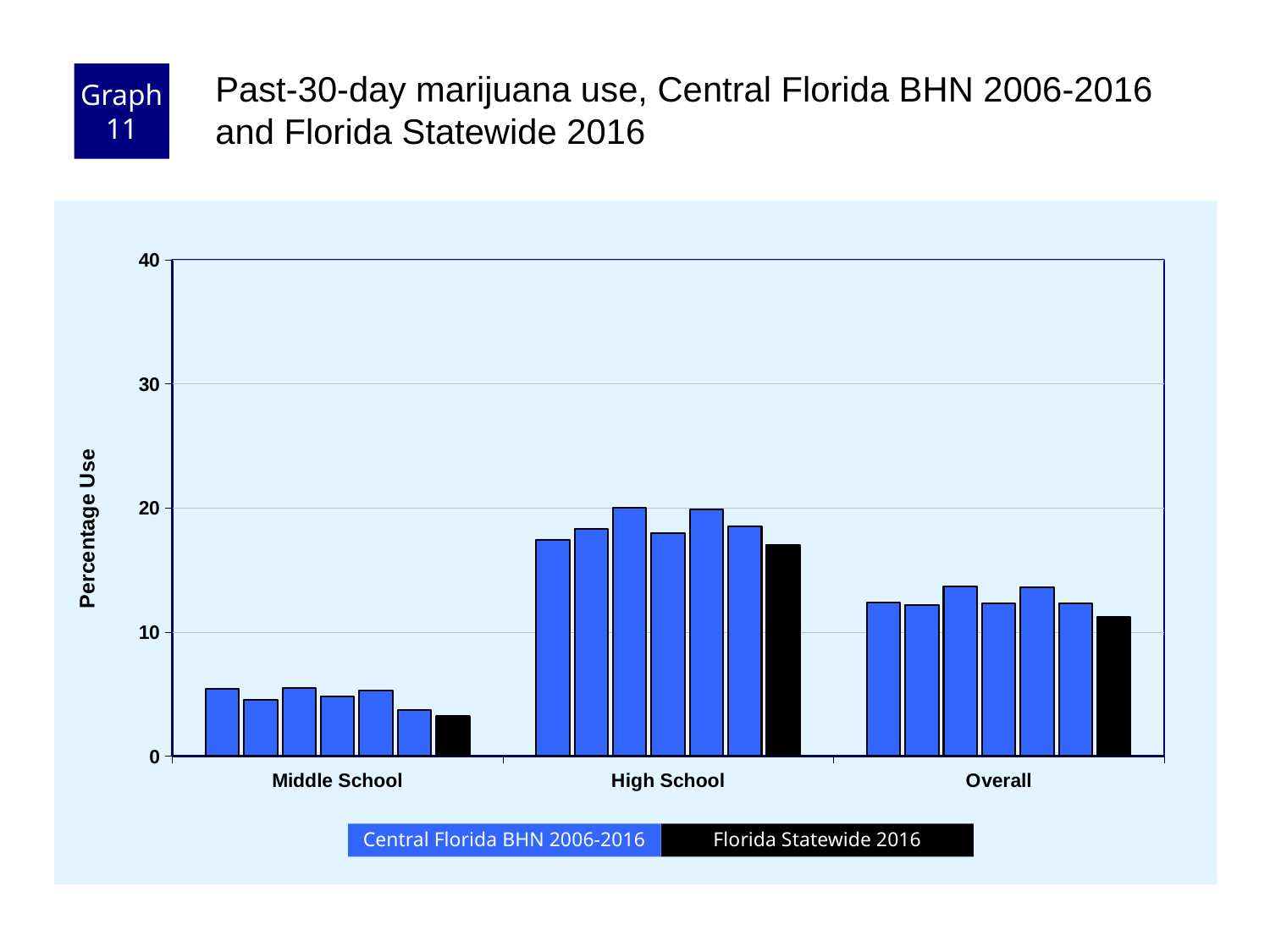
What kind of chart is shown on the slide? bar chart Which category has the lowest percentage use? Middle School Is the Florida Statewide 2016 value for High School greater or less than 20? less Is the Florida Statewide 2016 value for High School greater or less than 10? greater What is the label on the y axis? Percentage Use How many categories are shown on the x axis? 3 Which category has the highest percentage use? High School Is the Florida Statewide 2016 value for Middle School greater or less than 10? less How many bars are plotted for the High School category? 7 How many series does the legend list? 2 Which is larger, the Florida Statewide 2016 value for High School or for Overall? High School